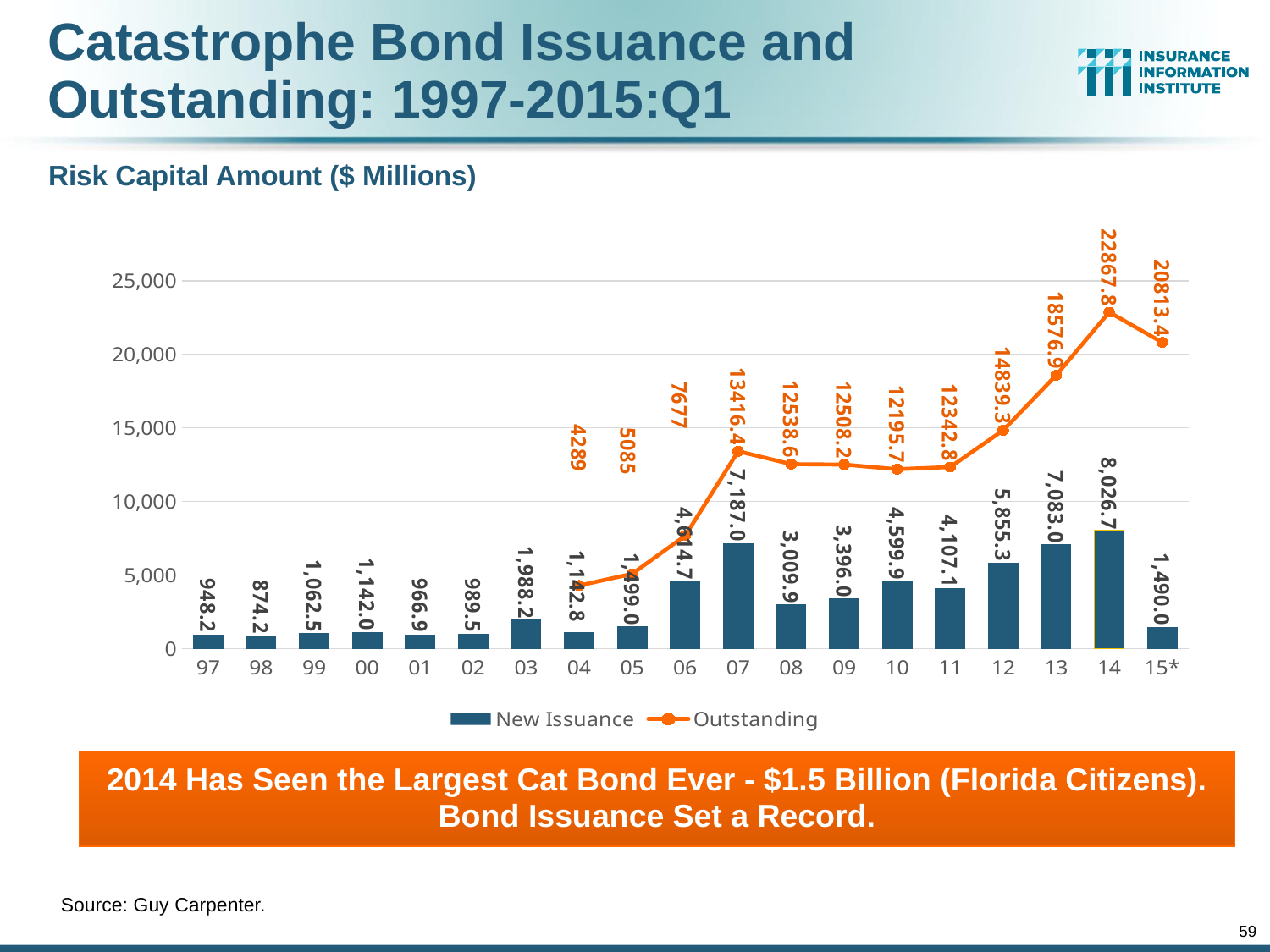
Which year has the lowest New Issuance value? 98 Which is larger, the New Issuance value for 2008 or for 2009? 2009 What is the New Issuance value for 15*? 1,490.0 Which year has the highest New Issuance value? 14 What is the difference between the Outstanding values for 2014 and 15*? 2054.4 What is the New Issuance value for 2007? 7,187.0 How many years are shown on the x axis? 19 What is the difference between the New Issuance values for 2014 and 2013? 943.7 What is the Outstanding value for 2013? 18576.9 How many series does the legend list? 2 Which year has the highest Outstanding value? 14 Does the Outstanding line rise or fall from 2012 to 2014? rise